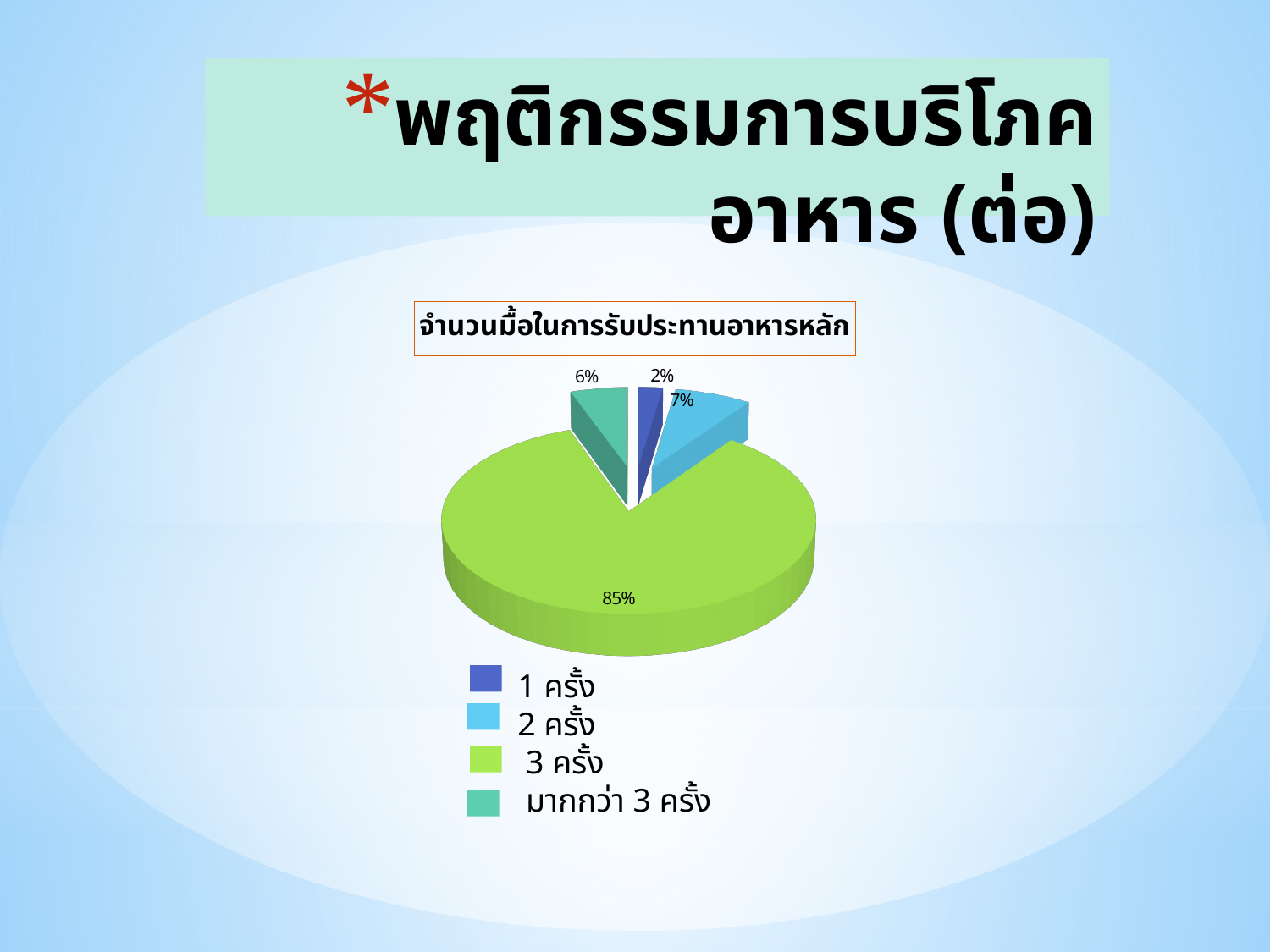
Which category has the smallest slice of the pie? 1 ครั้ง What is the title of the chart? จำนวนมื้อในการรับประทานอาหารหลัก What percentage of the pie is labelled for 3 ครั้ง? 85% What percentage of the pie is labelled for 1 ครั้ง? 2% Which category has the largest slice of the pie? 3 ครั้ง What is the difference in percentage points between the 3 ครั้ง slice and the 2 ครั้ง slice? 78 How many categories does the legend list? 4 What colour is the slice for 3 ครั้ง? Green What kind of chart is shown on the slide? Pie chart Which slice is larger, 2 ครั้ง or มากกว่า 3 ครั้ง? 2 ครั้ง What percentage of the pie is labelled for มากกว่า 3 ครั้ง? 6% What percentage of the pie is labelled for 2 ครั้ง? 7%